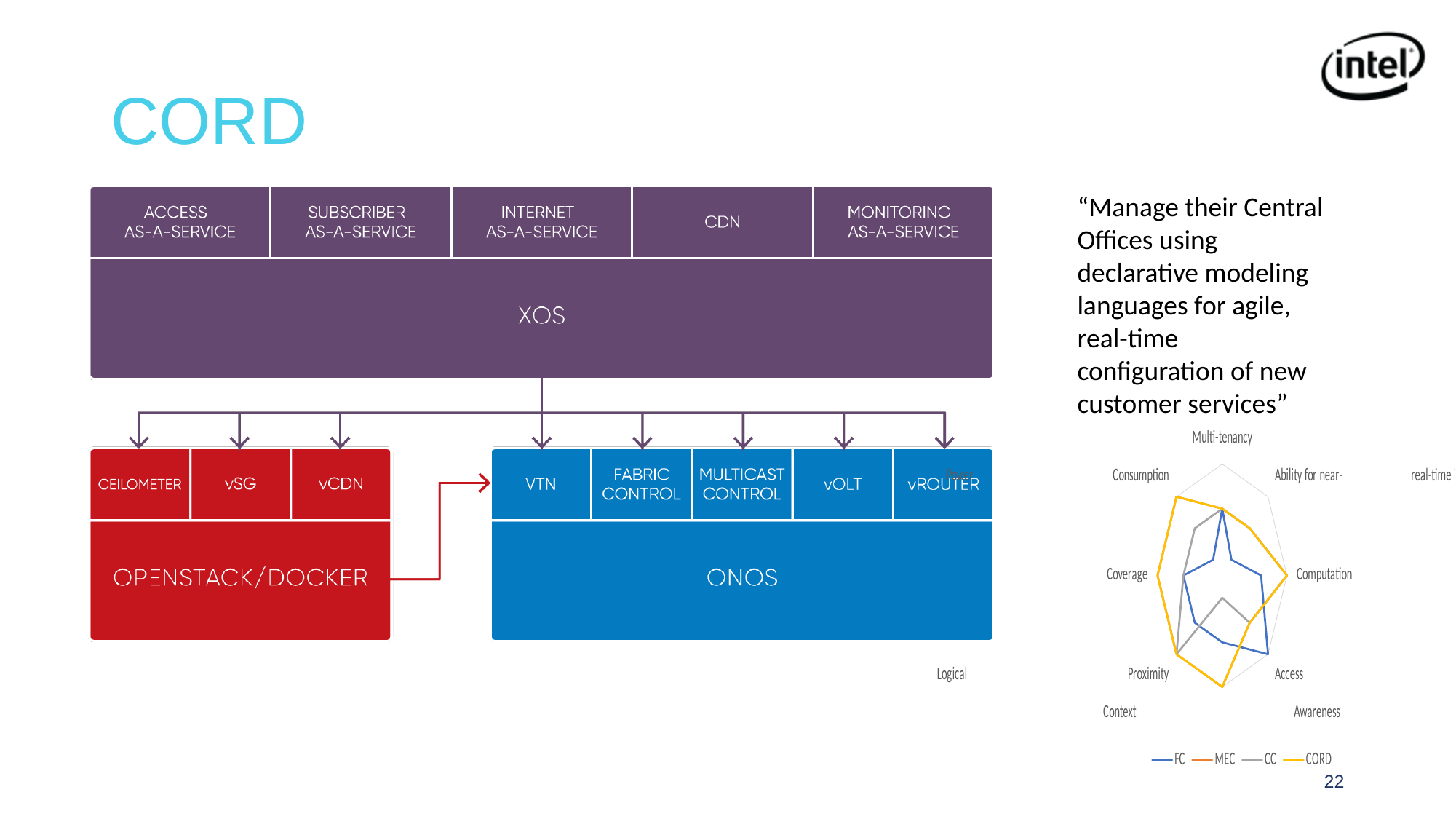
Which series are listed in the legend of the radar chart? FC, MEC, CC, CORD How many series does the legend of the radar chart list? 4 In the radar chart, which series extends further along the Computation axis, CORD or FC? CORD In the radar chart, which series extends furthest along the Coverage axis? CORD (tied with MEC) In the radar chart, which series is drawn with the yellow line? CORD In the radar chart, which series extends further along the Coverage axis, CORD or FC? CORD What kind of chart is shown at the bottom right of the slide? Radar chart In the radar chart, which series extends further along the Access axis, FC or CC? FC